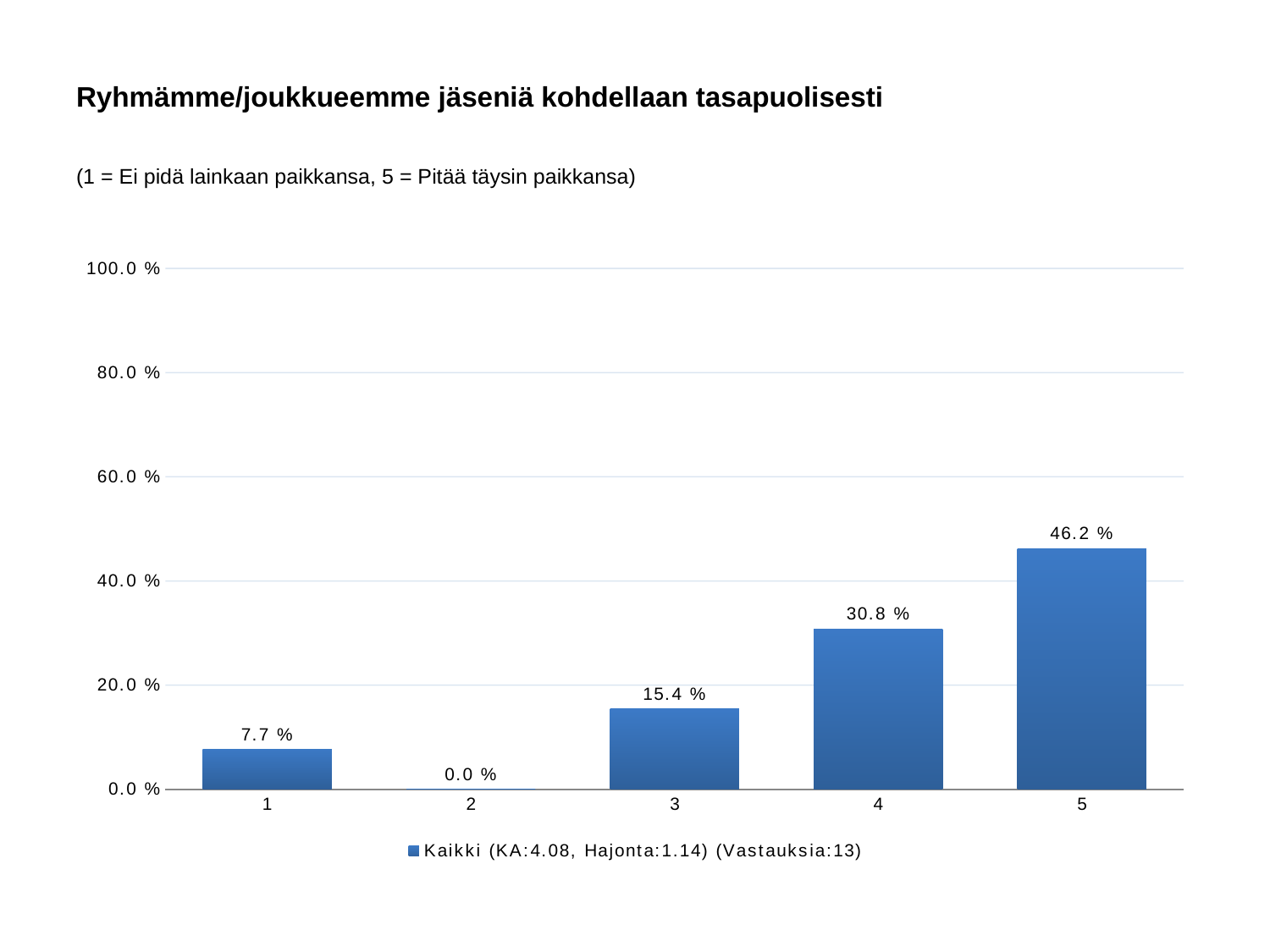
Which category has the highest value? 5 What is the value for category 1? 7.7 % How many categories are shown on the x axis? 5 What is the value for category 5? 46.2 % How many series does the legend list? 1 Which is larger, the value for category 3 or the value for category 1? 3 What is the difference between the values for category 5 and category 4? 15.4 % What is the title of the chart? Ryhmämme/joukkueemme jäseniä kohdellaan tasapuolisesti What kind of chart is shown on the slide? bar chart Which category has the lowest value? 2 What is the value for category 3? 15.4 % Is the value for category 4 greater or less than 40.0 %? less